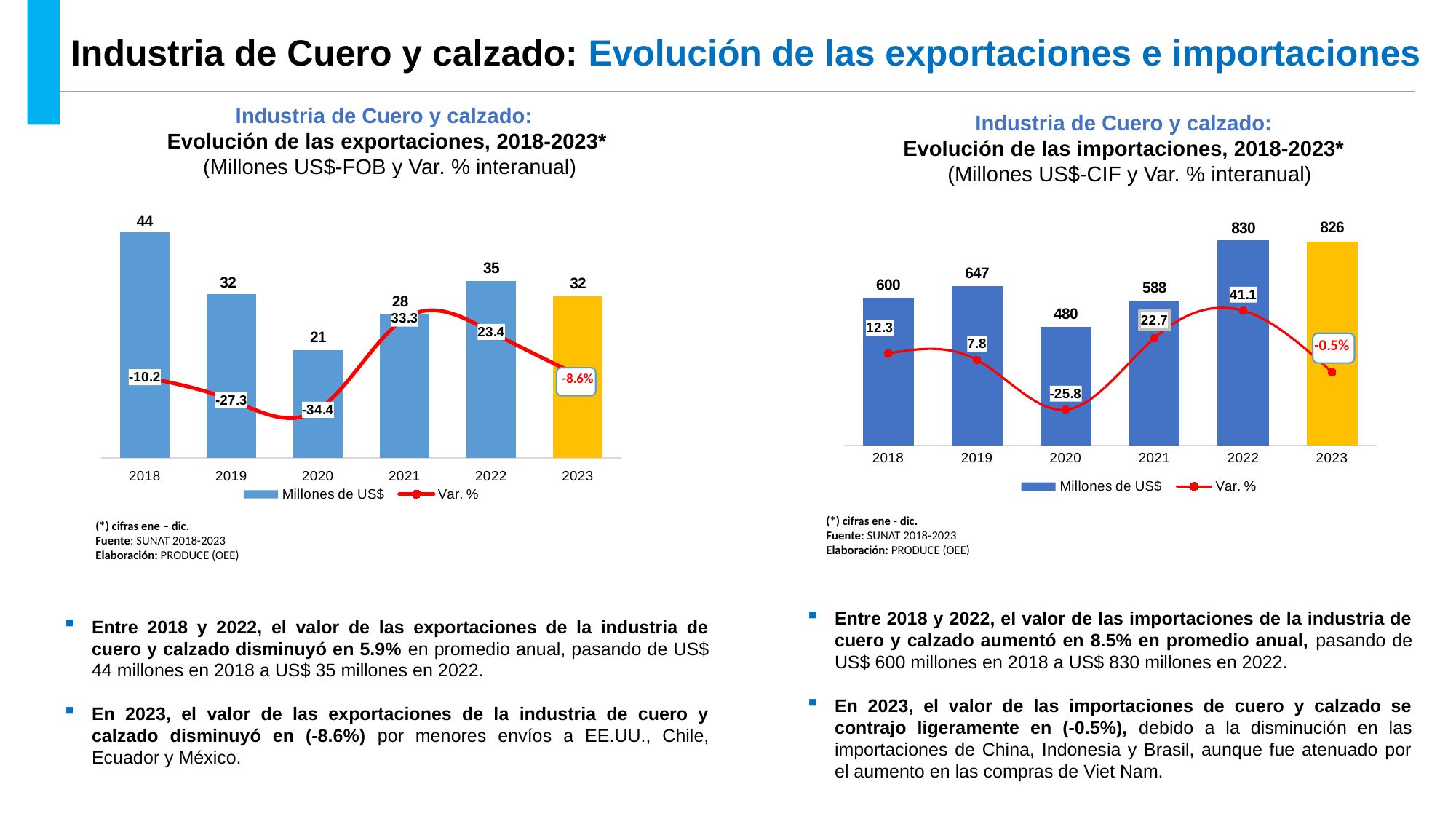
In the imports chart (right), what is the difference in Millones de US$ between 2022 and 2023? 4 In the exports chart (left), what is the difference in Millones de US$ between 2018 and 2022? 9 In the imports chart (right), what is the value in Millones de US$ for 2020? 480 In the imports chart (right), how many years are shown on the x axis? 6 In the exports chart (left), how many series does the legend list? 2 In the exports chart (left), what is the value in Millones de US$ for 2018? 44 What type of chart is the exports chart (left)? Bar chart with a line In the imports chart (right), which year has the highest value in Millones de US$? 2022 In the imports chart (right), which is larger in Millones de US$: 2019 or 2021? 2019 In the exports chart (left), what is the Var. % value for 2020? -34.4 In the exports chart (left), which year has the lowest value in Millones de US$? 2020 In the imports chart (right), what is the Var. % value for 2022? 41.1